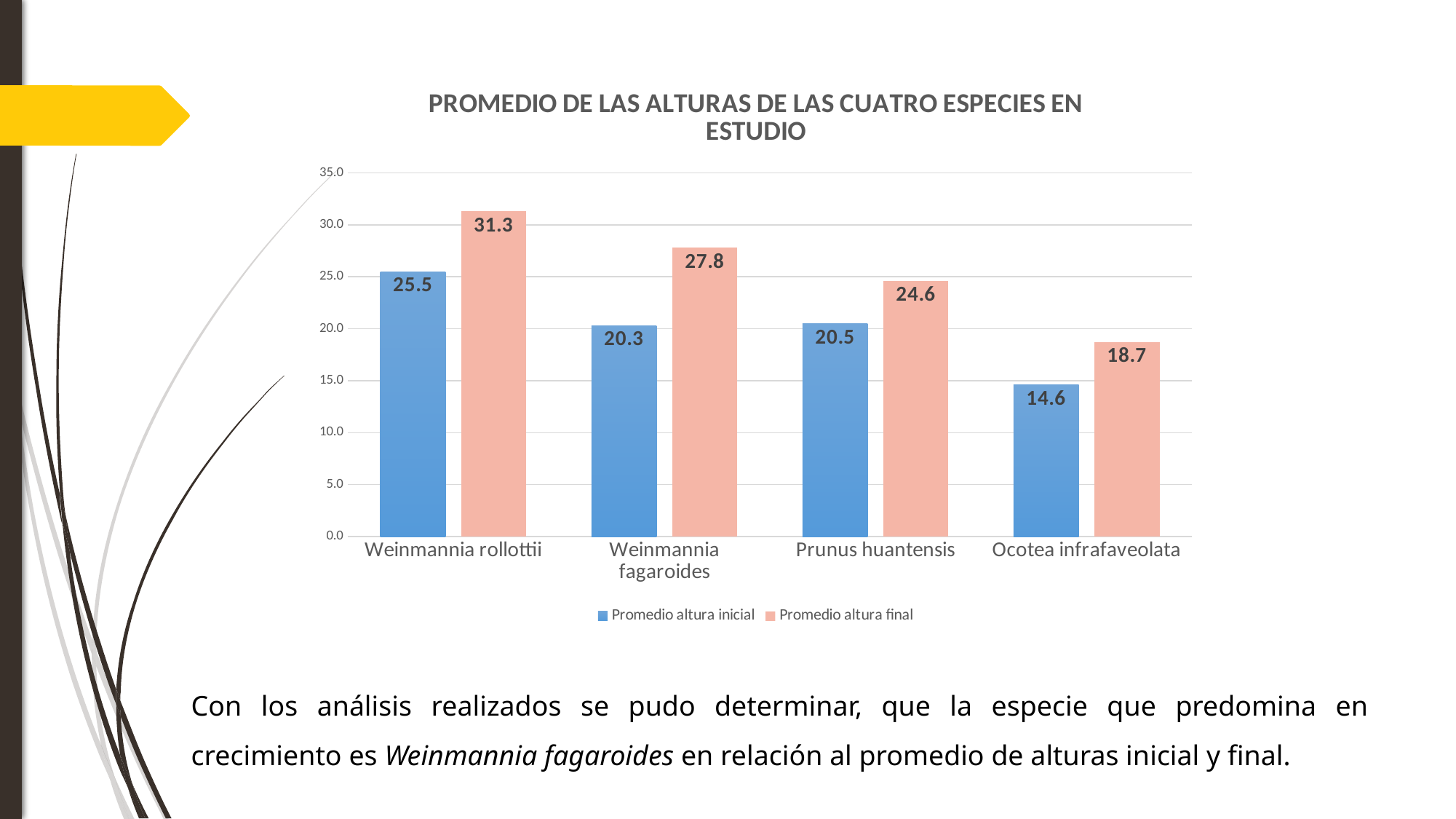
How many species are shown on the x axis of the chart? 4 Is the Promedio altura final for Weinmannia rollottii greater or less than 30.0? greater What is the title of the chart? PROMEDIO DE LAS ALTURAS DE LAS CUATRO ESPECIES EN ESTUDIO How many series does the legend list? 2 Which species has the lowest Promedio altura inicial? Ocotea infrafaveolata Which species has the highest Promedio altura final? Weinmannia rollottii What is the difference between the Promedio altura final and Promedio altura inicial for Weinmannia fagaroides? 7.5 What is the Promedio altura final value for Ocotea infrafaveolata? 18.7 Which is larger: the Promedio altura inicial for Weinmannia fagaroides or for Prunus huantensis? Prunus huantensis What is the Promedio altura inicial value for Weinmannia rollottii? 25.5 What kind of chart is shown on the slide? Bar chart What is the Promedio altura final value for Prunus huantensis? 24.6